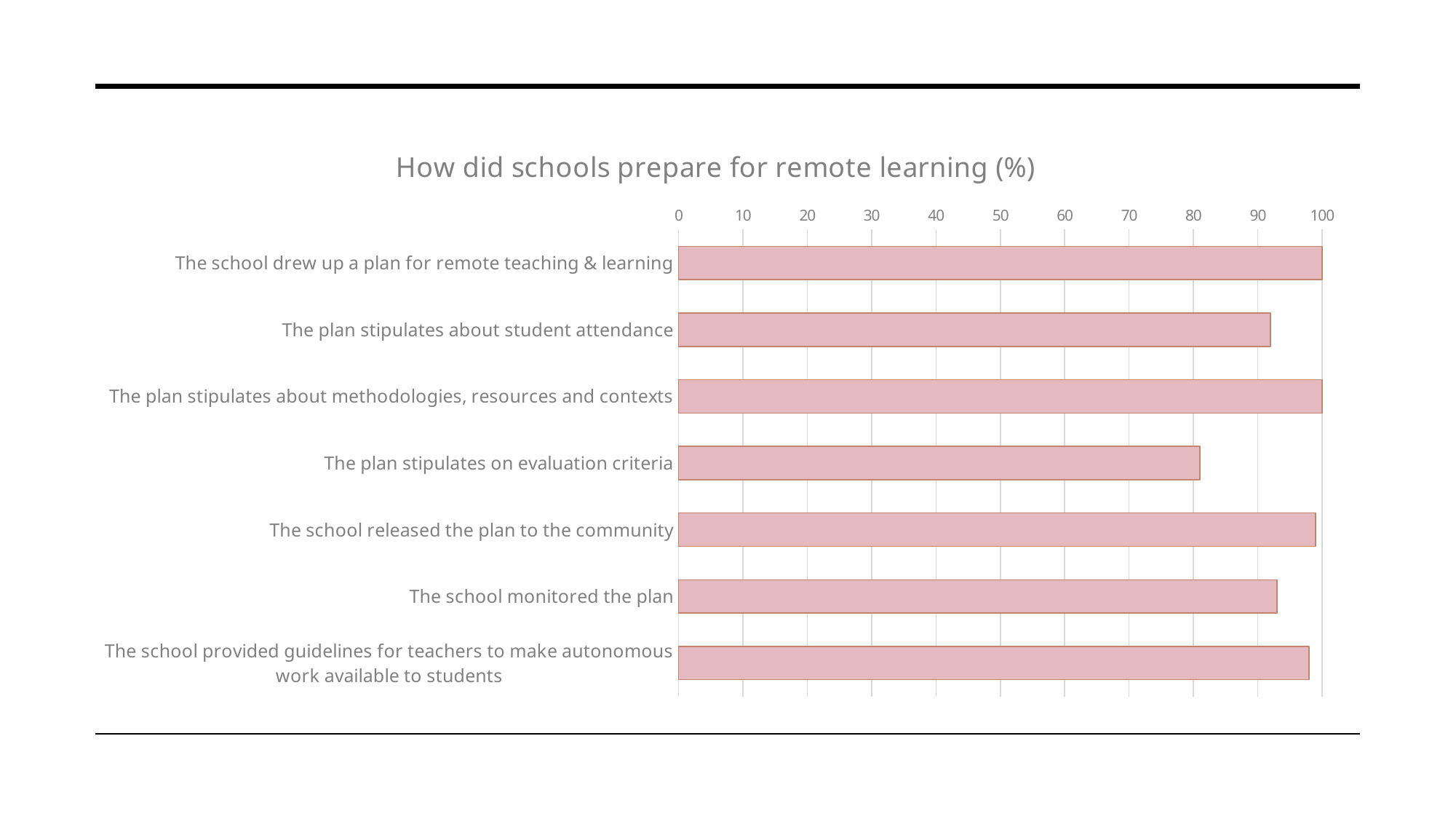
What is the title of the chart? How did schools prepare for remote learning (%) How many categories are plotted in the chart? 7 Is the value for 'The plan stipulates about student attendance' greater or less than 100? less Which is larger: the value for 'The plan stipulates about student attendance' or 'The plan stipulates on evaluation criteria'? The plan stipulates about student attendance Is the value for 'The plan stipulates on evaluation criteria' greater or less than 90? less Which category has the lowest value? The plan stipulates on evaluation criteria What is the maximum value shown on the horizontal axis? 100 Which is larger: the value for 'The school released the plan to the community' or 'The school monitored the plan'? The school released the plan to the community Is the value for 'The school provided guidelines for teachers to make autonomous work available to students' greater or less than 90? greater What kind of chart is shown on the slide? bar chart What is the value for 'The school drew up a plan for remote teaching & learning'? 100